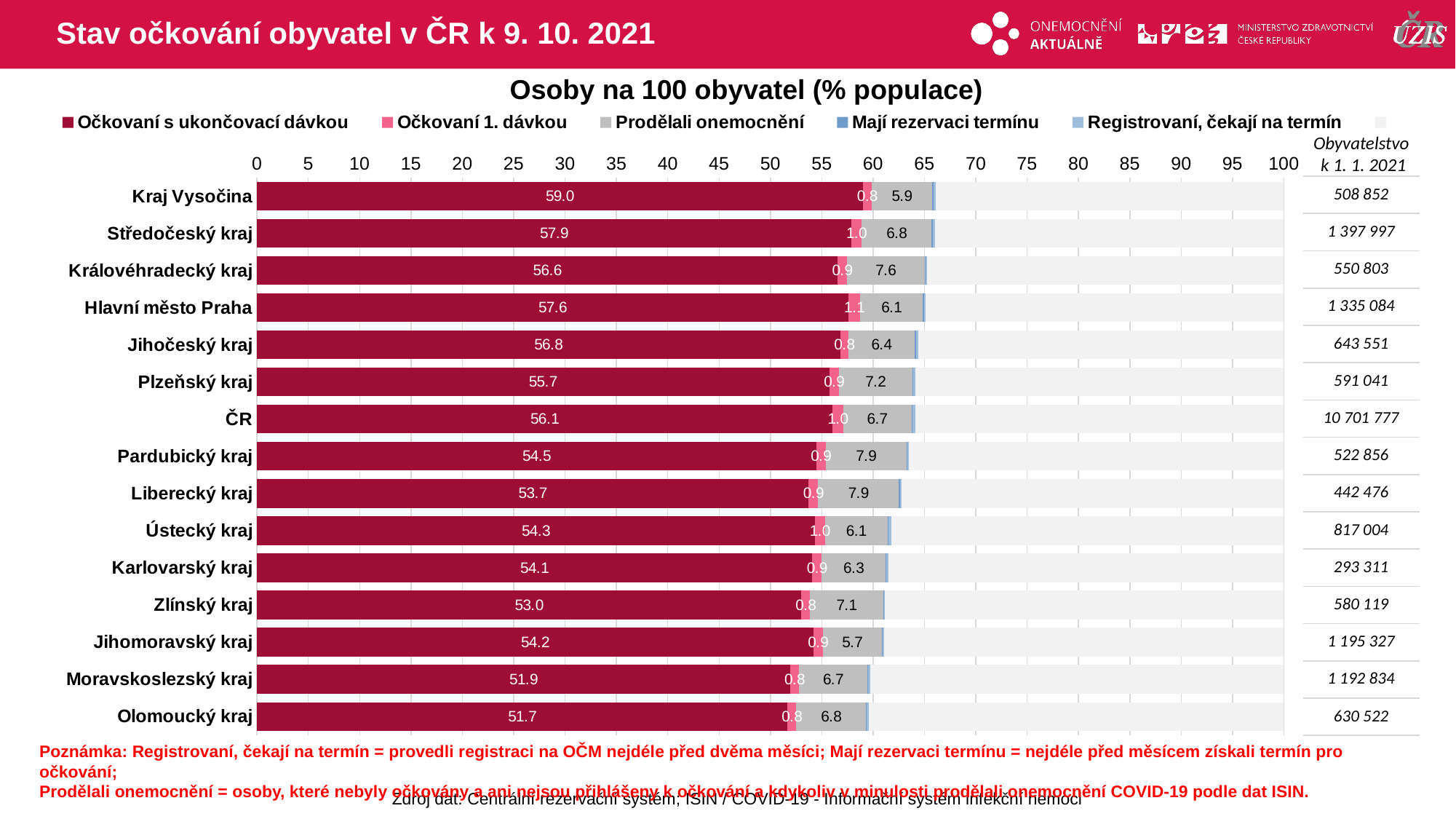
Which region has the highest value of Očkovaní s ukončovací dávkou? Kraj Vysočina What is the value of Prodělali onemocnění for ČR? 6.7 What is the value of Očkovaní s ukončovací dávkou for Kraj Vysočina? 59.0 What is the value of Očkovaní 1. dávkou for Hlavní město Praha? 1.1 What is the difference in Očkovaní s ukončovací dávkou between Kraj Vysočina and Olomoucký kraj? 7.3 Is the value of Očkovaní s ukončovací dávkou for Olomoucký kraj greater or less than 55? less What type of chart is shown on the slide? Bar chart How many categories (rows) are shown in the chart? 15 Which region has the lowest value of Očkovaní s ukončovací dávkou? Olomoucký kraj Which region has the lowest value of Prodělali onemocnění? Jihomoravský kraj Which has a larger value of Prodělali onemocnění, Královéhradecký kraj or Jihomoravský kraj? Královéhradecký kraj What is the value of Očkovaní s ukončovací dávkou for Moravskoslezský kraj? 51.9